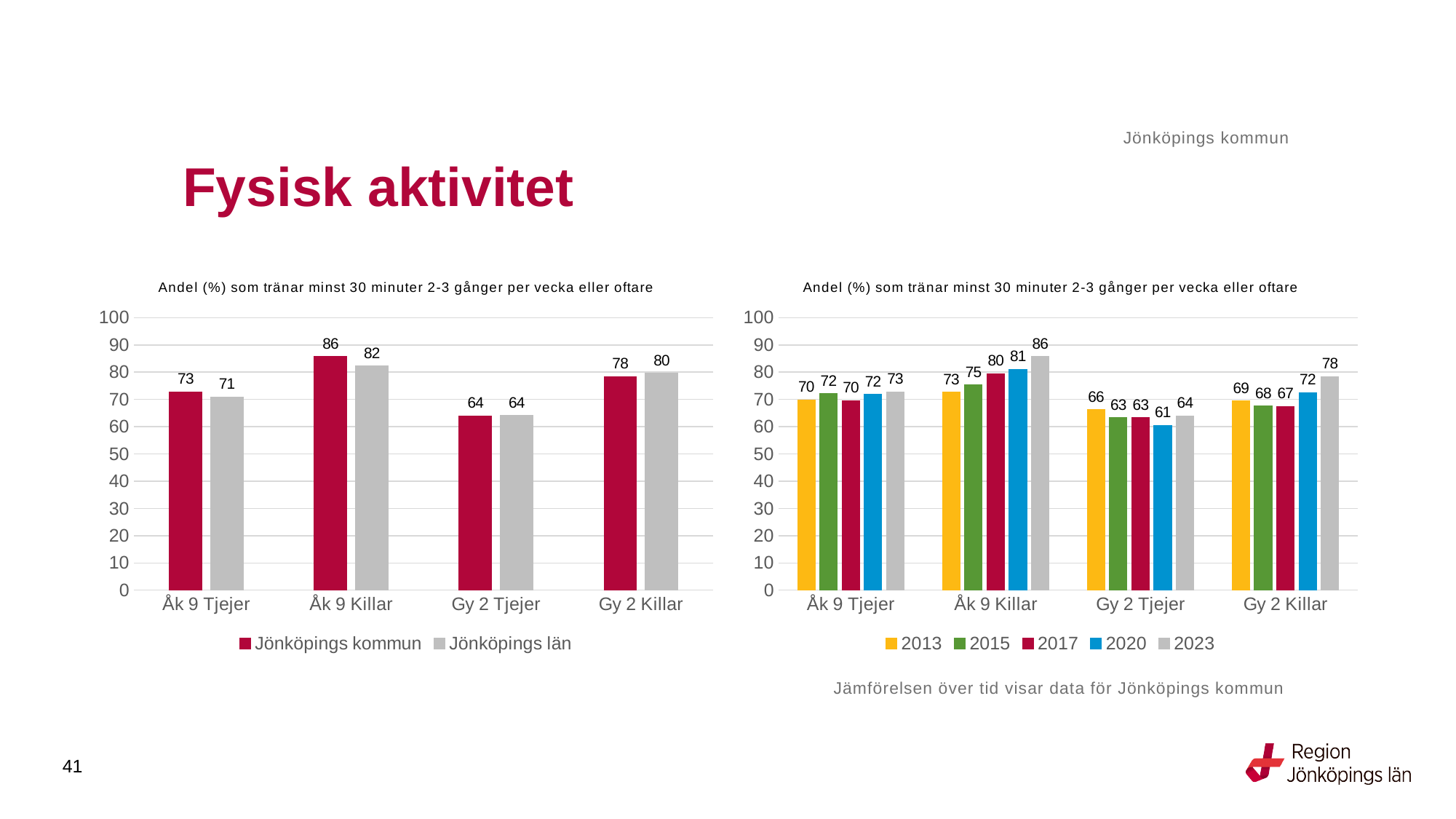
In the left chart, what is the difference between Jönköpings kommun and Jönköpings län for Åk 9 Killar? 4 In the right chart, how many categories are shown on the x axis? 4 In the right chart, what is the difference between 2013 and 2023 for Gy 2 Killar? 9 In the left chart, which category has the lowest value for Jönköpings kommun? Gy 2 Tjejer In the left chart, what is the value for Jönköpings län for Åk 9 Tjejer? 71 In the left chart, what is the value for Jönköpings kommun for Åk 9 Killar? 86 In the right chart, how many series does the legend list? 5 In the left chart, which is larger for Gy 2 Killar: Jönköpings kommun or Jönköpings län? Jönköpings län In the left chart, how many series does the legend list? 2 What kind of chart is the right chart? Bar chart In the right chart, what is the value for 2020 for Gy 2 Tjejer? 61 In the right chart, what is the value for 2023 for Åk 9 Killar? 86